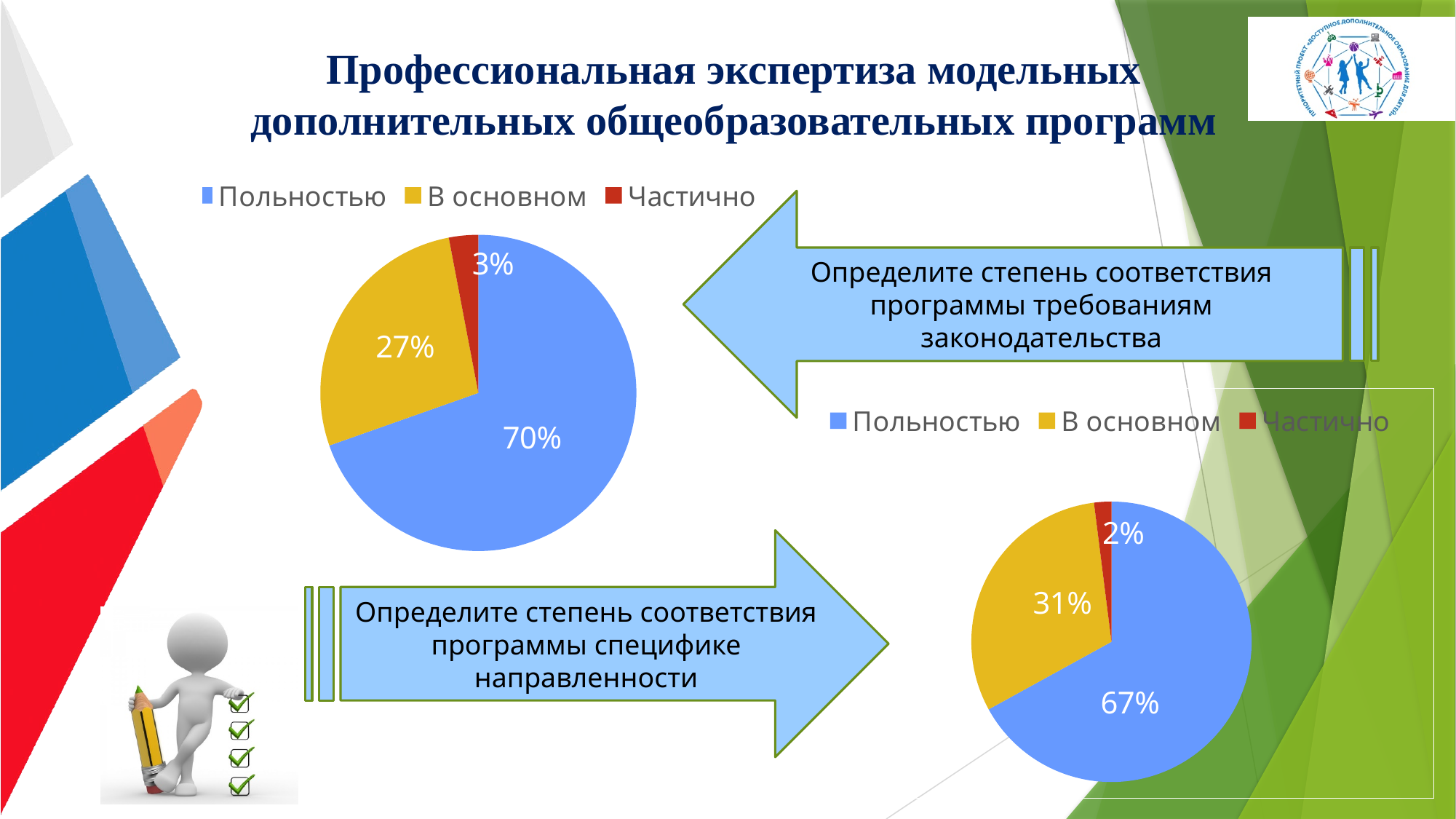
In the upper-left pie chart, what share is labelled for В основном? 27% In the lower-right pie chart, which category has the smallest slice? Частично In the upper-left pie chart, what share is labelled for Частично? 3% In the upper-left pie chart, what share is labelled for Польностью? 70% Which is larger: the В основном share in the upper-left pie chart or the В основном share in the lower-right pie chart? the lower-right pie chart (31%) In the lower-right pie chart, what share is labelled for Польностью? 67% What type of chart is the upper-left chart on the slide? pie chart In the upper-left pie chart, which category has the largest slice? Польностью In the lower-right pie chart, what share is labelled for В основном? 31% In the upper-left pie chart, what is the difference between the Польностью and В основном shares? 43% In the lower-right pie chart, what share is labelled for Частично? 2% How many categories does the legend of the lower-right pie chart list? 3